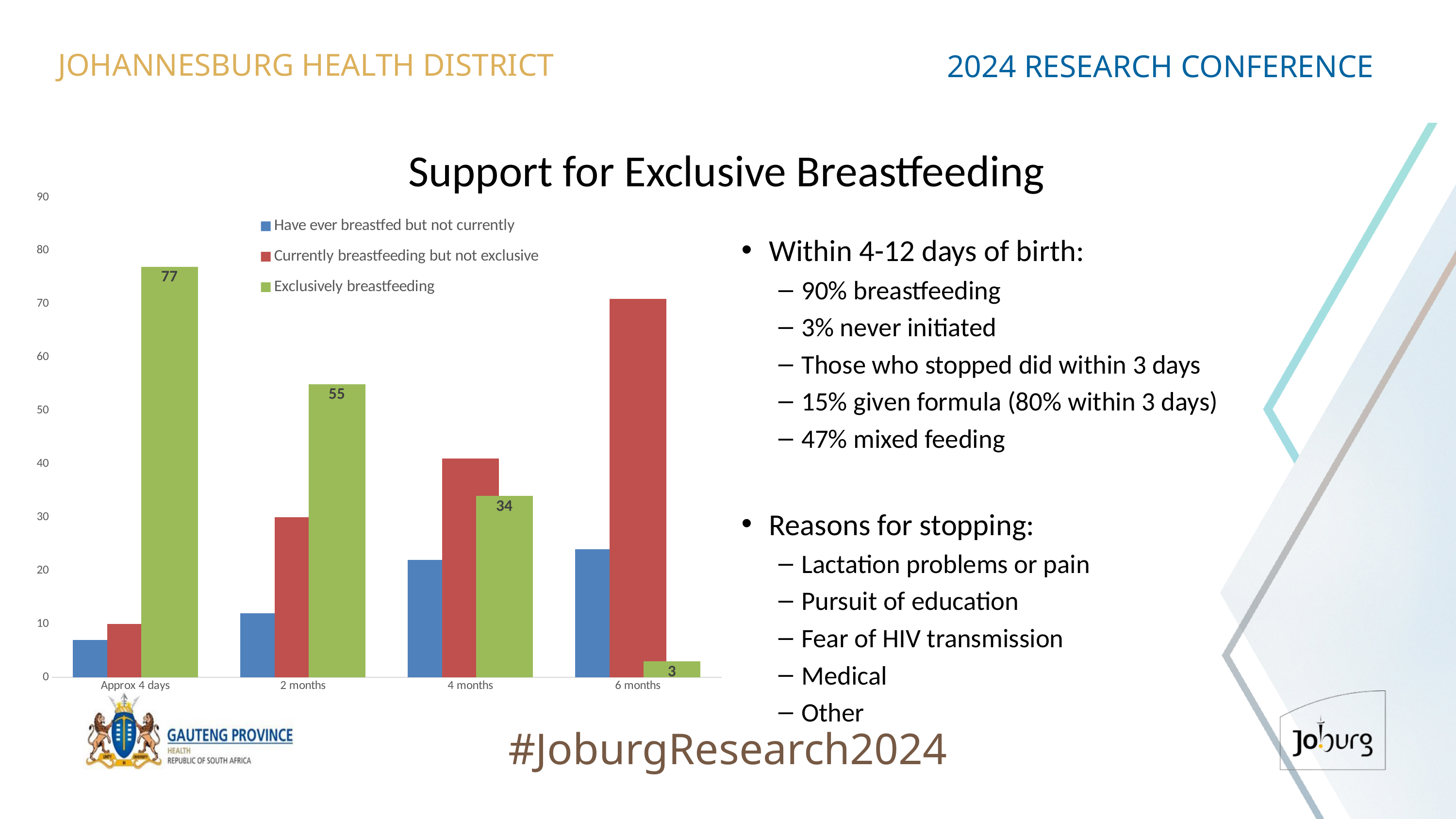
Does the Exclusively breastfeeding series rise or fall from Approx 4 days to 6 months? fall Which category has the highest value for Exclusively breastfeeding? Approx 4 days Is the value for Currently breastfeeding but not exclusive at 6 months greater or less than 60? greater What is the difference between the Exclusively breastfeeding values at 4 months and 6 months? 31 What is the difference between the Exclusively breastfeeding values at Approx 4 days and 2 months? 22 Which category has the lowest value for Exclusively breastfeeding? 6 months What is the value for Exclusively breastfeeding at Approx 4 days? 77 How many series does the legend list? 3 At 6 months, which is larger: Currently breastfeeding but not exclusive or Exclusively breastfeeding? Currently breastfeeding but not exclusive What is the value for Exclusively breastfeeding at 6 months? 3 What is the value for Exclusively breastfeeding at 2 months? 55 How many categories are shown on the x axis? 4